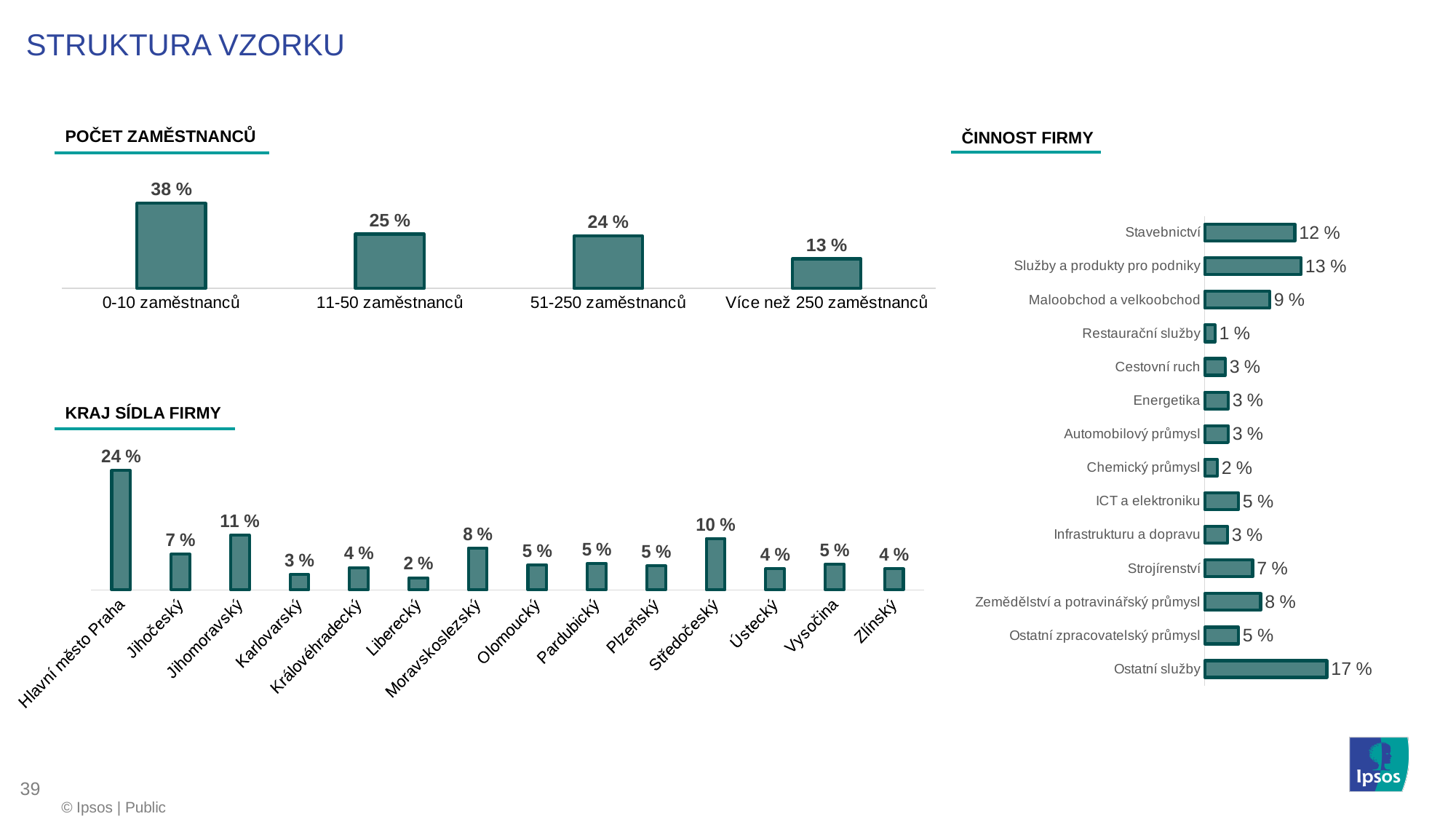
In the KRAJ SÍDLA FIRMY chart, what is the value for Jihomoravský? 11 % In the ČINNOST FIRMY chart, which category has the highest value? Ostatní služby In the POČET ZAMĚSTNANCŮ chart, which category has the lowest value? Více než 250 zaměstnanců In the POČET ZAMĚSTNANCŮ chart, what is the value for 0-10 zaměstnanců? 38 % In the KRAJ SÍDLA FIRMY chart, which category has the lowest value? Liberecký In the KRAJ SÍDLA FIRMY chart, how many categories are shown? 14 In the KRAJ SÍDLA FIRMY chart, which category has the highest value? Hlavní město Praha In the POČET ZAMĚSTNANCŮ chart, what is the difference between 0-10 zaměstnanců and 11-50 zaměstnanců? 13 % In the ČINNOST FIRMY chart, what is the value for Strojírenství? 7 % In the POČET ZAMĚSTNANCŮ chart, how many categories are shown? 4 What kind of chart is the ČINNOST FIRMY chart? Bar chart In the KRAJ SÍDLA FIRMY chart, which is larger, Středočeský or Moravskoslezský? Středočeský